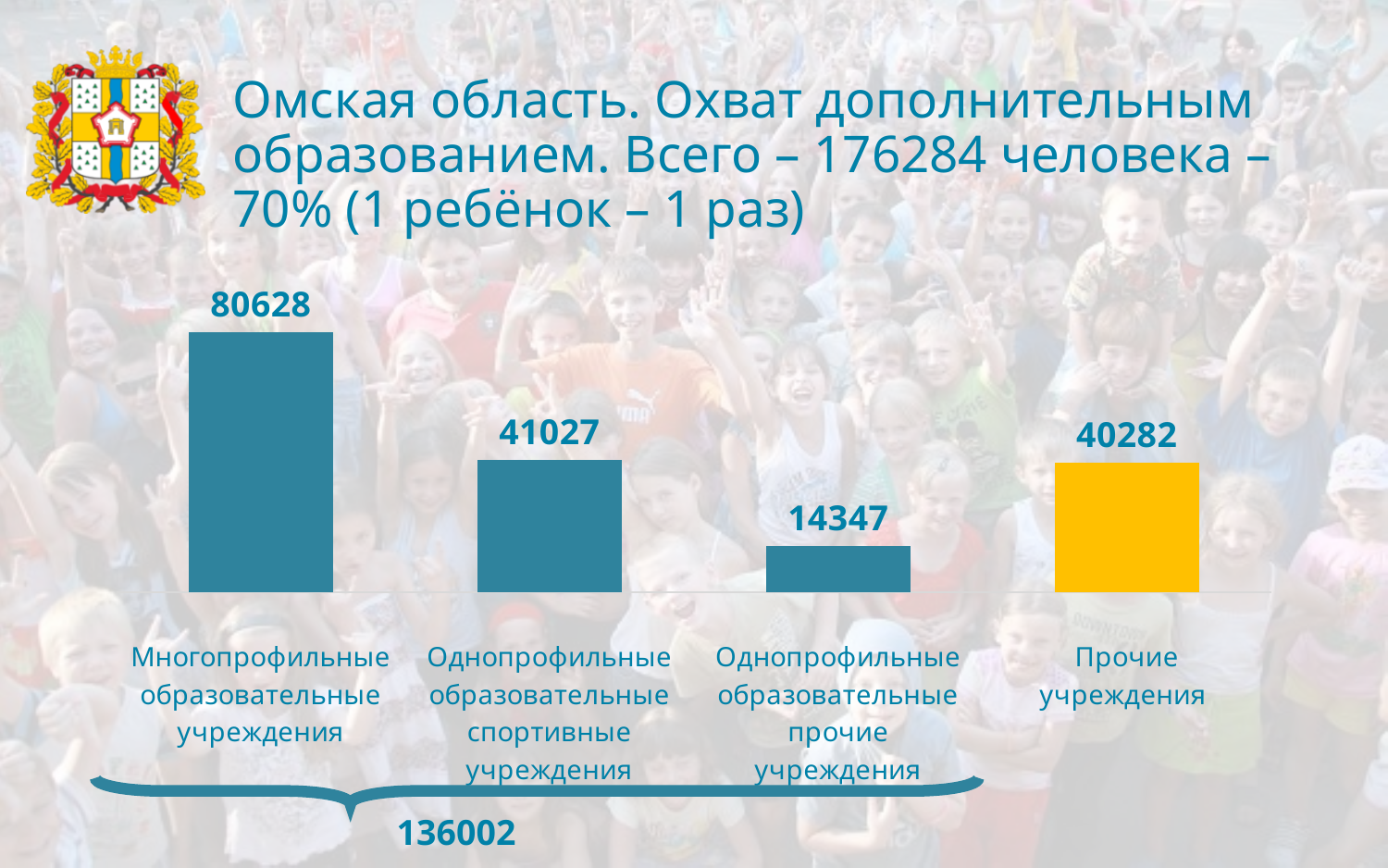
What is the value for Однопрофильные образовательные спортивные учреждения? 41027 Which category has the lowest value? Однопрофильные образовательные прочие учреждения What is the difference between the values for Многопрофильные образовательные учреждения and Однопрофильные образовательные спортивные учреждения? 39601 What total is shown by the bracket under the first three bars? 136002 What kind of chart is shown on the slide? Bar chart Which is larger: the value for Однопрофильные образовательные спортивные учреждения or for Прочие учреждения? Однопрофильные образовательные спортивные учреждения What is the difference between the values for Прочие учреждения and Однопрофильные образовательные прочие учреждения? 25935 What is the value for Прочие учреждения? 40282 Which category has the highest value? Многопрофильные образовательные учреждения What is the value for Многопрофильные образовательные учреждения? 80628 How many categories are shown in the chart? 4 What is the value for Однопрофильные образовательные прочие учреждения? 14347